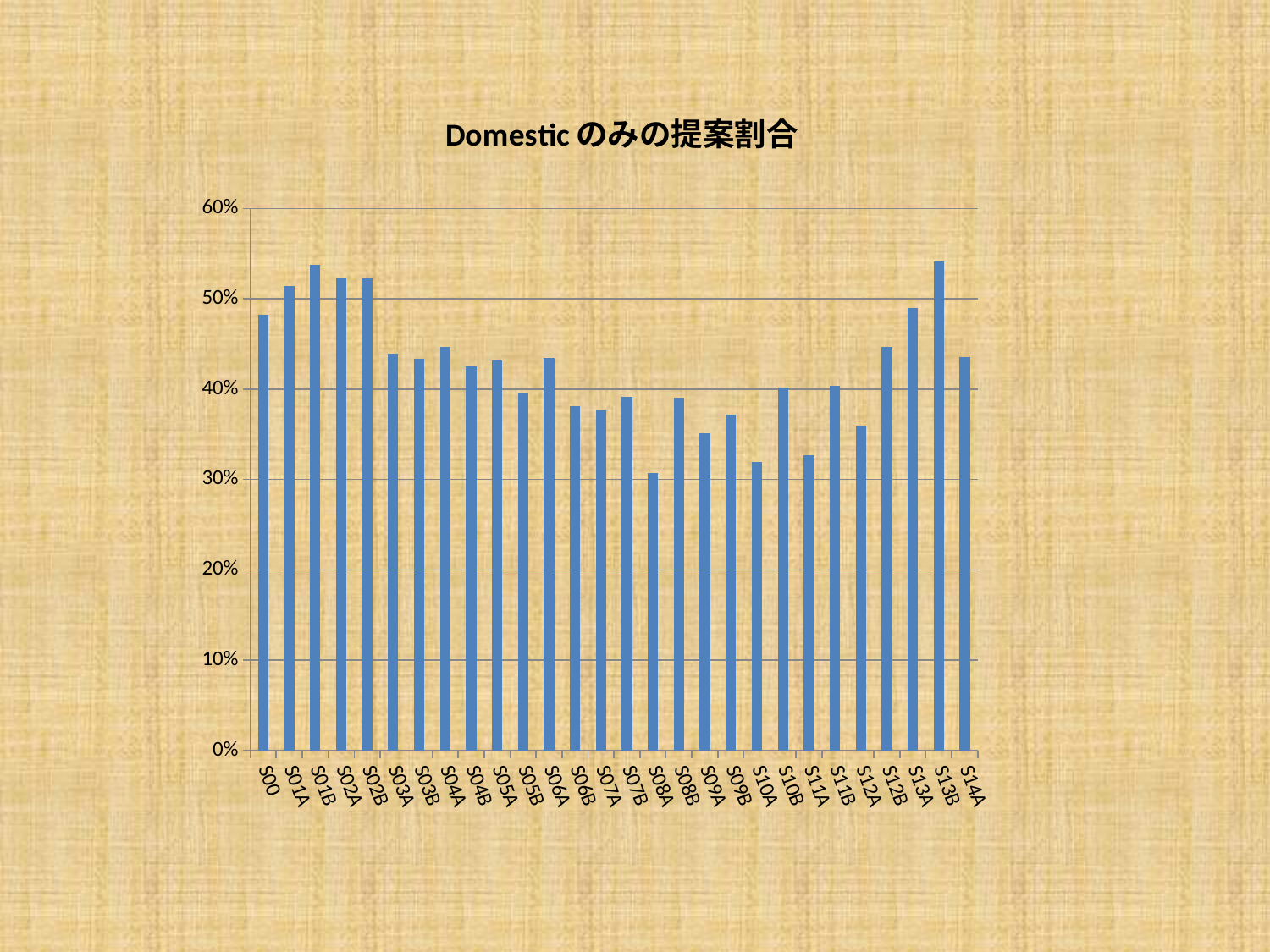
From S02B to S08A, do the values generally rise or fall? fall Which is larger, the value for S12B or the value for S08A? S12B What kind of chart is shown on the slide? bar chart Is the value for S08A greater or less than 40%? less What is the title of the chart? Domestic のみの提案割合 Is the value for S10A greater or less than 40%? less Is the value for S12A greater or less than 40%? less Which category has the lowest value? S08A Which is larger, the value for S01A or the value for S09A? S01A How many categories are plotted along the x axis? 28